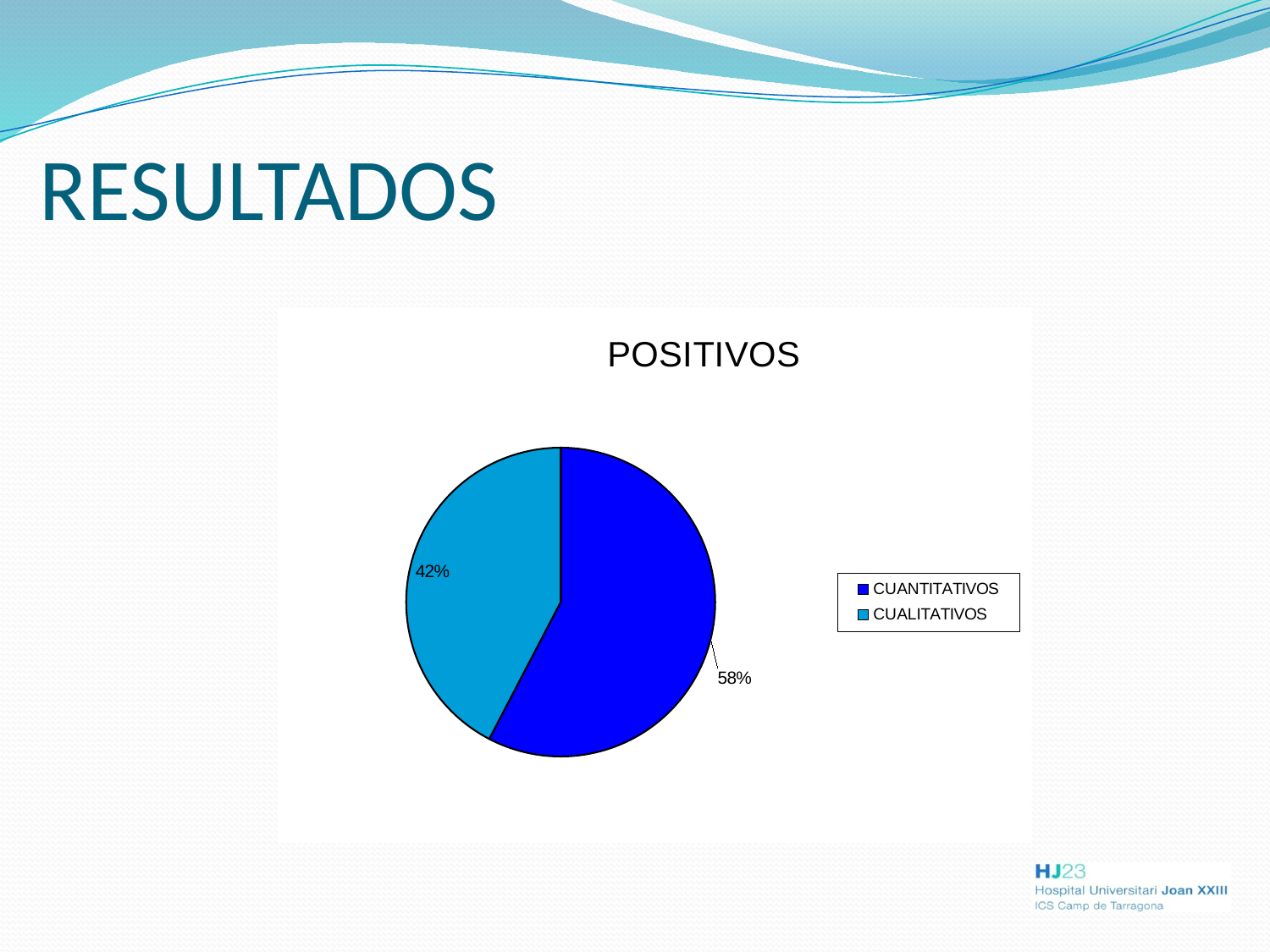
What share of the pie does CUANTITATIVOS represent? 58% Which slice is larger, CUANTITATIVOS or CUALITATIVOS? CUANTITATIVOS What share of the pie does CUALITATIVOS represent? 42% What is the difference in percentage points between the CUANTITATIVOS and CUALITATIVOS slices? 16 What kind of chart is shown on the slide? pie chart Which legend entry is shown in the lighter blue colour? CUALITATIVOS Which category has the smallest slice of the pie? CUALITATIVOS Which category has the largest slice of the pie? CUANTITATIVOS What is the title of the chart? POSITIVOS How many categories does the pie chart show? 2 Is the share for CUALITATIVOS greater or less than 50%? less How many entries does the legend list? 2